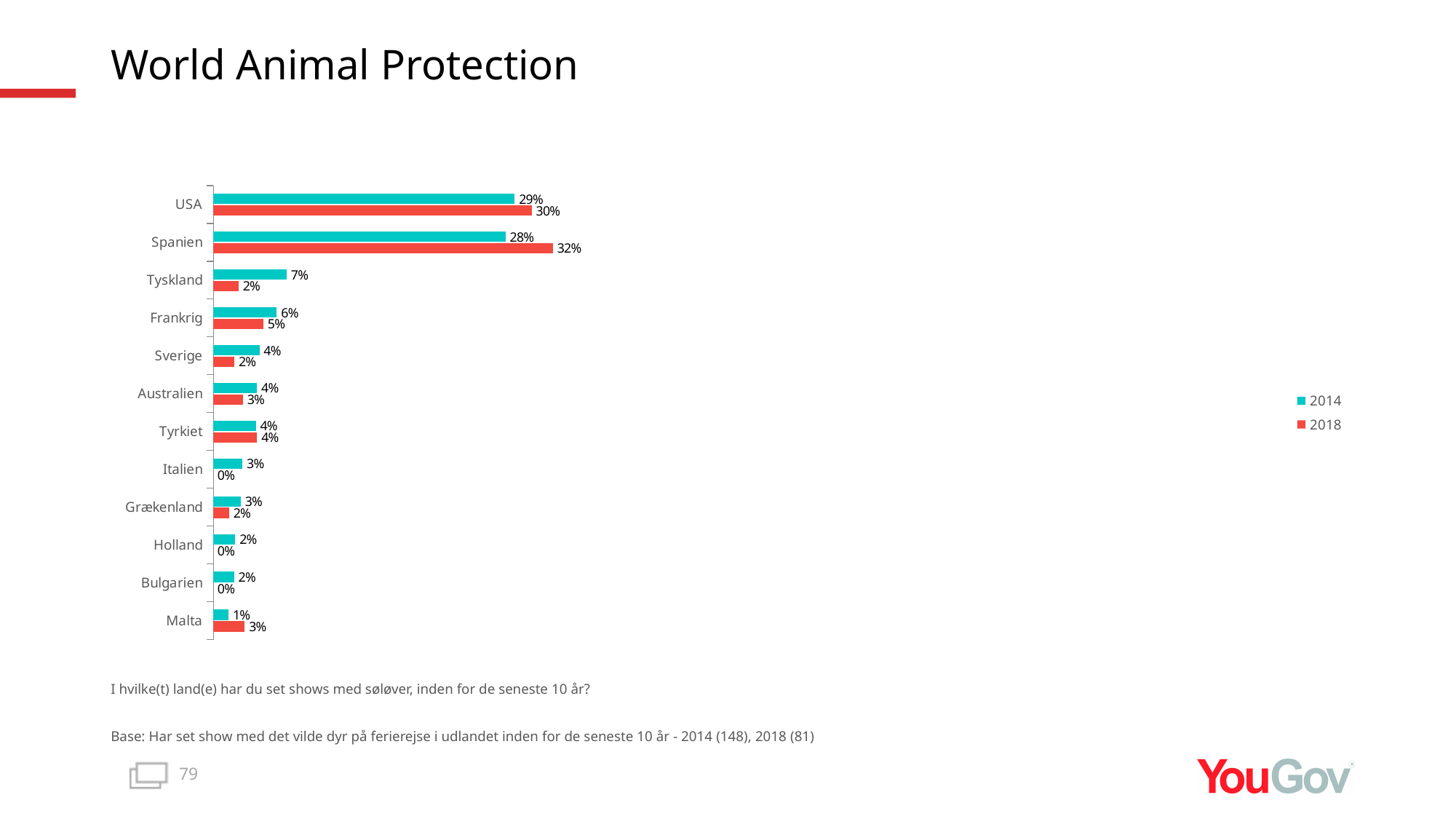
What is the difference between the 2018 values for USA and Spanien? 2% What is the difference between the 2014 and 2018 values for Tyskland? 5% What is the 2018 value for Malta? 3% What is the 2014 value for Tyskland? 7% What kind of chart is shown on the slide? Bar chart Which colour represents the 2018 series in the legend? Red What is the 2018 value for Spanien? 32% Which country has the lowest 2014 value? Malta Which is larger for USA: the 2014 value or the 2018 value? 2018 Which country has the highest 2018 value? Spanien How many series does the legend list? 2 How many countries are shown on the chart? 12